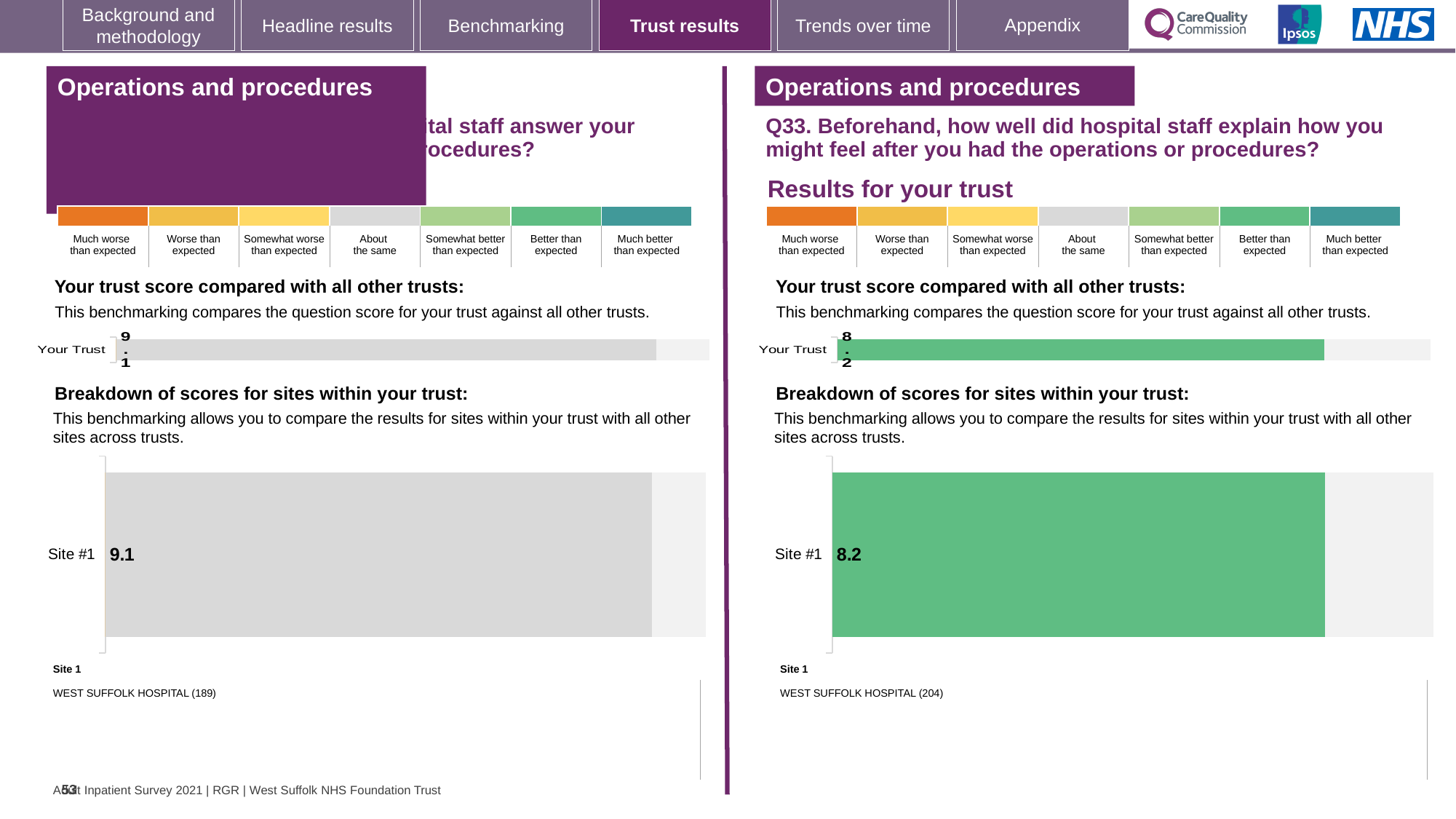
On the left panel, what score is shown for Site #1 in the 'Breakdown of scores for sites within your trust' chart? 9.1 On the right panel (Q33), which benchmark category does the colour of the Your Trust bar correspond to? Better than expected How many sites are shown in the 'Breakdown of scores for sites within your trust' chart on the right panel (Q33)? 1 On the left panel, what respondent count is shown in brackets for Site 1, WEST SUFFOLK HOSPITAL? 189 On the right panel (Q33), what score is shown for Site #1 in the 'Breakdown of scores for sites within your trust' chart? 8.2 What is the difference between the Site #1 score on the left panel and the Site #1 score on the right panel (Q33)? 0.9 On the right panel (Q33), what is the score shown for Your Trust in the 'Your trust score compared with all other trusts' chart? 8.2 What type of chart is used to show the Site #1 score on the left panel? Bar chart Which is larger: the Your Trust score on the left panel or the Your Trust score on the right panel (Q33)? Left panel (9.1) On the left panel, which benchmark category does the colour of the Site #1 bar correspond to? About the same On the left panel, what is the score shown for Your Trust in the 'Your trust score compared with all other trusts' chart? 9.1 On the right panel (Q33), what is the name of Site 1 and its respondent count shown below the chart? WEST SUFFOLK HOSPITAL (204)